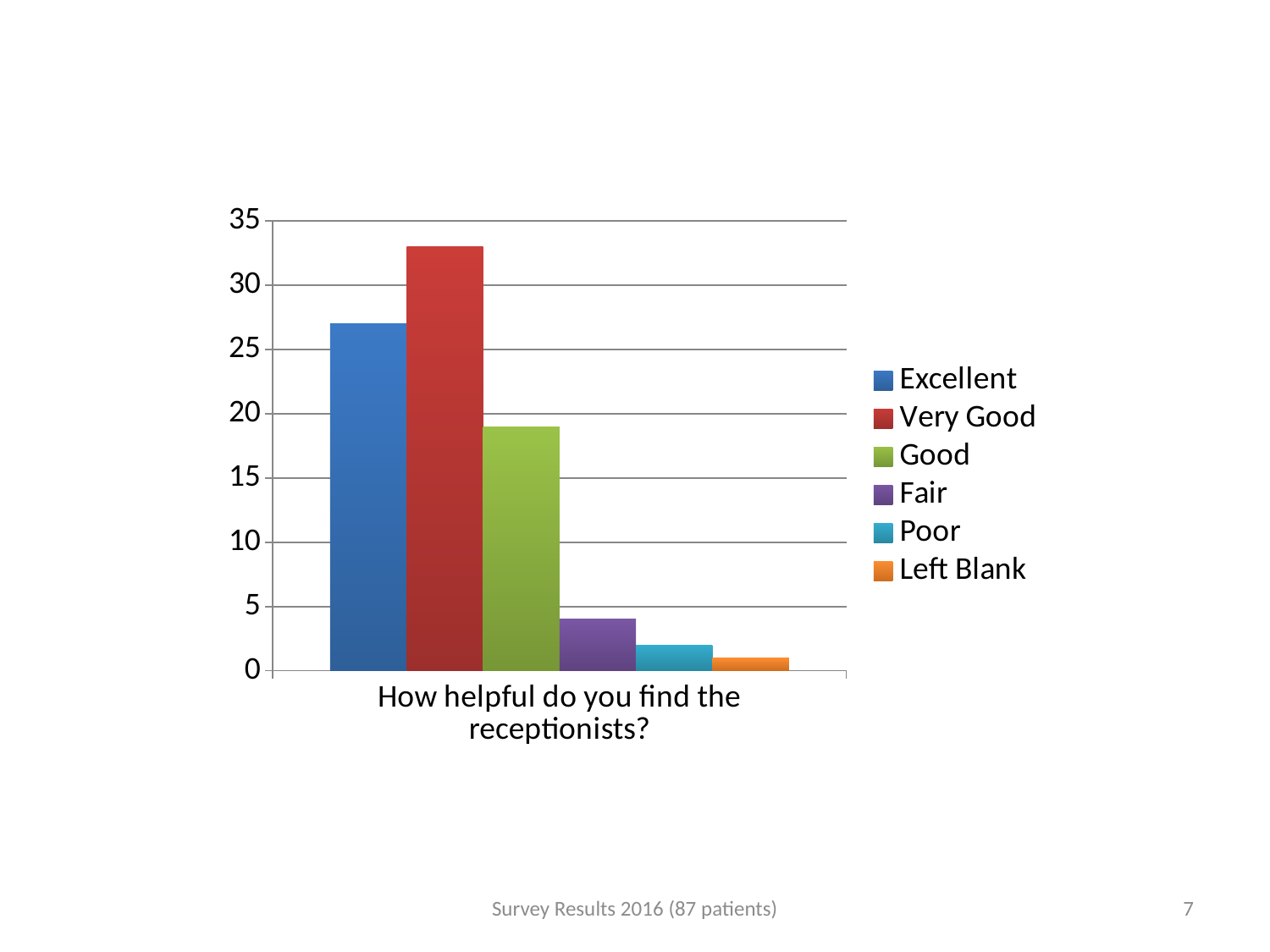
What colour is the bar for Poor? light blue How many series does the legend list? 6 Is the value for Excellent greater or less than 25? greater Which is larger, the value for Good or the value for Fair? Good Is the value for Good greater or less than 20? less Is the value for Very Good greater or less than 30? greater What question is shown as the category label beneath the bars? How helpful do you find the receptionists? Which response has the lowest bar? Left Blank Which response has the highest bar? Very Good What kind of chart is shown on the slide? bar chart Which is larger, the value for Excellent or the value for Very Good? Very Good